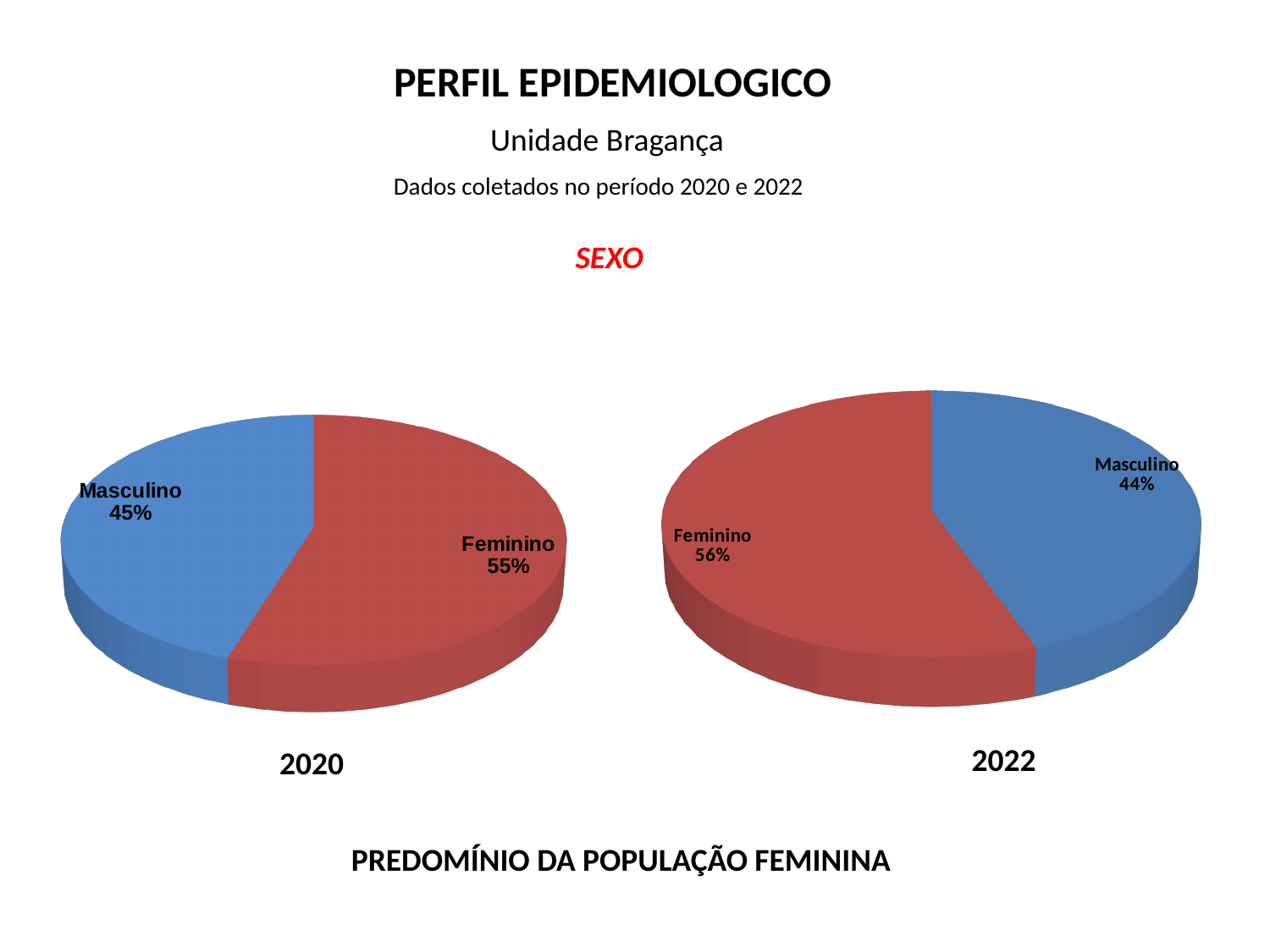
In the 2022 pie chart, what is the difference between the Feminino and Masculino shares? 12% How many slices does the 2022 pie chart have? 2 In the 2022 pie chart, what is the value for Masculino? 44% What kind of chart is the 2020 chart? Pie chart In the 2020 pie chart, what is the value for Masculino? 45% In the 2020 pie chart, which category has the largest share? Feminino In the 2022 pie chart, which category has the smallest share? Masculino In the 2020 pie chart, what is the difference between the Feminino and Masculino shares? 10% In the 2020 pie chart, which is larger, Feminino or Masculino? Feminino In the 2022 pie chart, what colour is the Masculino slice? Blue In the 2022 pie chart, what is the value for Feminino? 56% In the 2020 pie chart, what is the value for Feminino? 55%